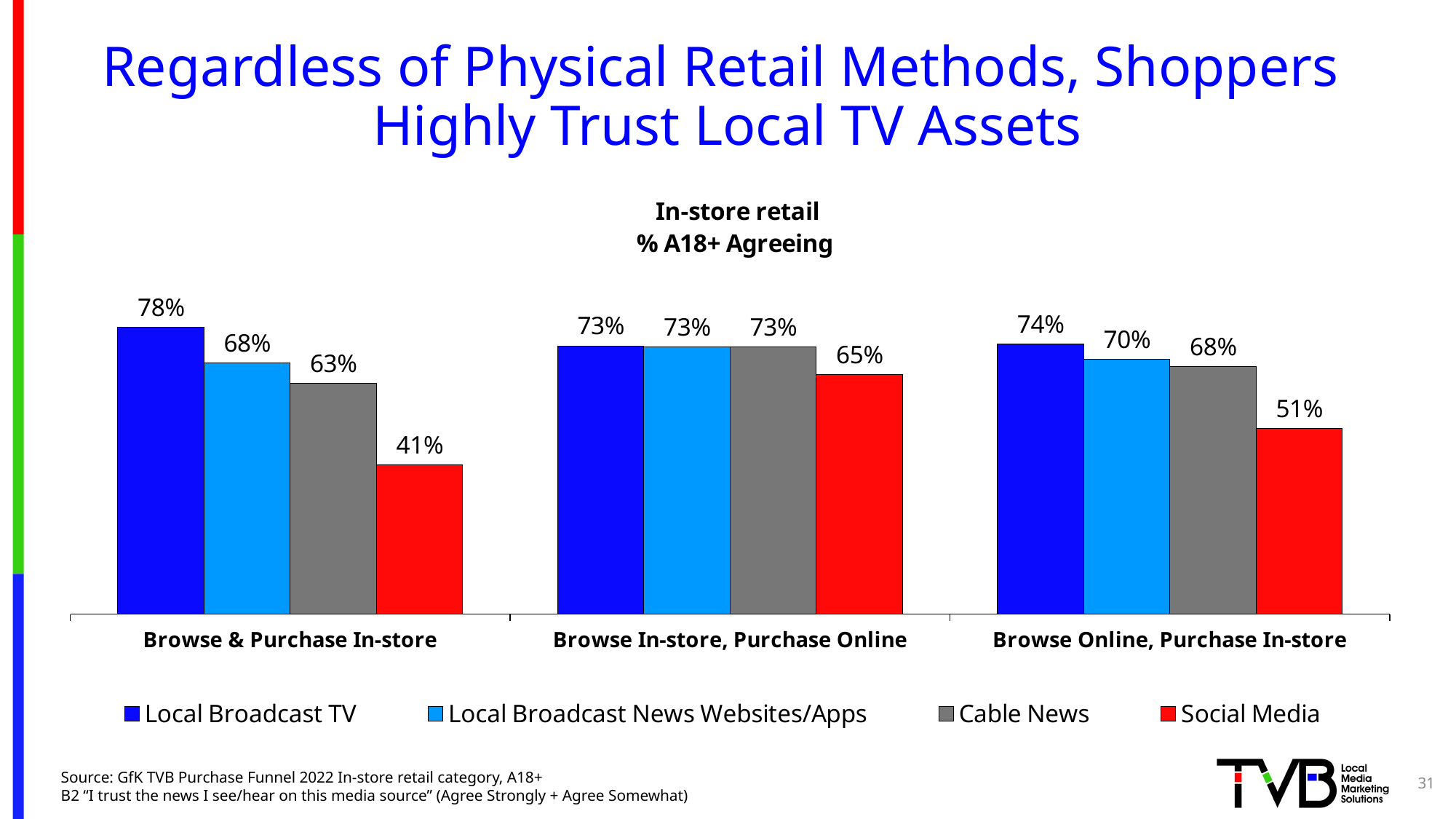
Which is larger: Social Media in Browse In-store, Purchase Online or Social Media in Browse Online, Purchase In-store? Browse In-store, Purchase Online What kind of chart is shown on the slide? Bar chart Which series has the highest value in the Browse Online, Purchase In-store category? Local Broadcast TV What is the value for Local Broadcast TV in the Browse & Purchase In-store category? 78% How many series does the legend list? 4 What is the value for Local Broadcast News Websites/Apps in the Browse Online, Purchase In-store category? 70% What is the difference between Local Broadcast TV and Social Media in the Browse & Purchase In-store category? 37% Which series has the lowest value in the Browse & Purchase In-store category? Social Media What is the value for Social Media in the Browse Online, Purchase In-store category? 51% How many categories are shown on the x axis? 3 What is the value for Cable News in the Browse In-store, Purchase Online category? 73% What is the title of the chart? In-store retail % A18+ Agreeing